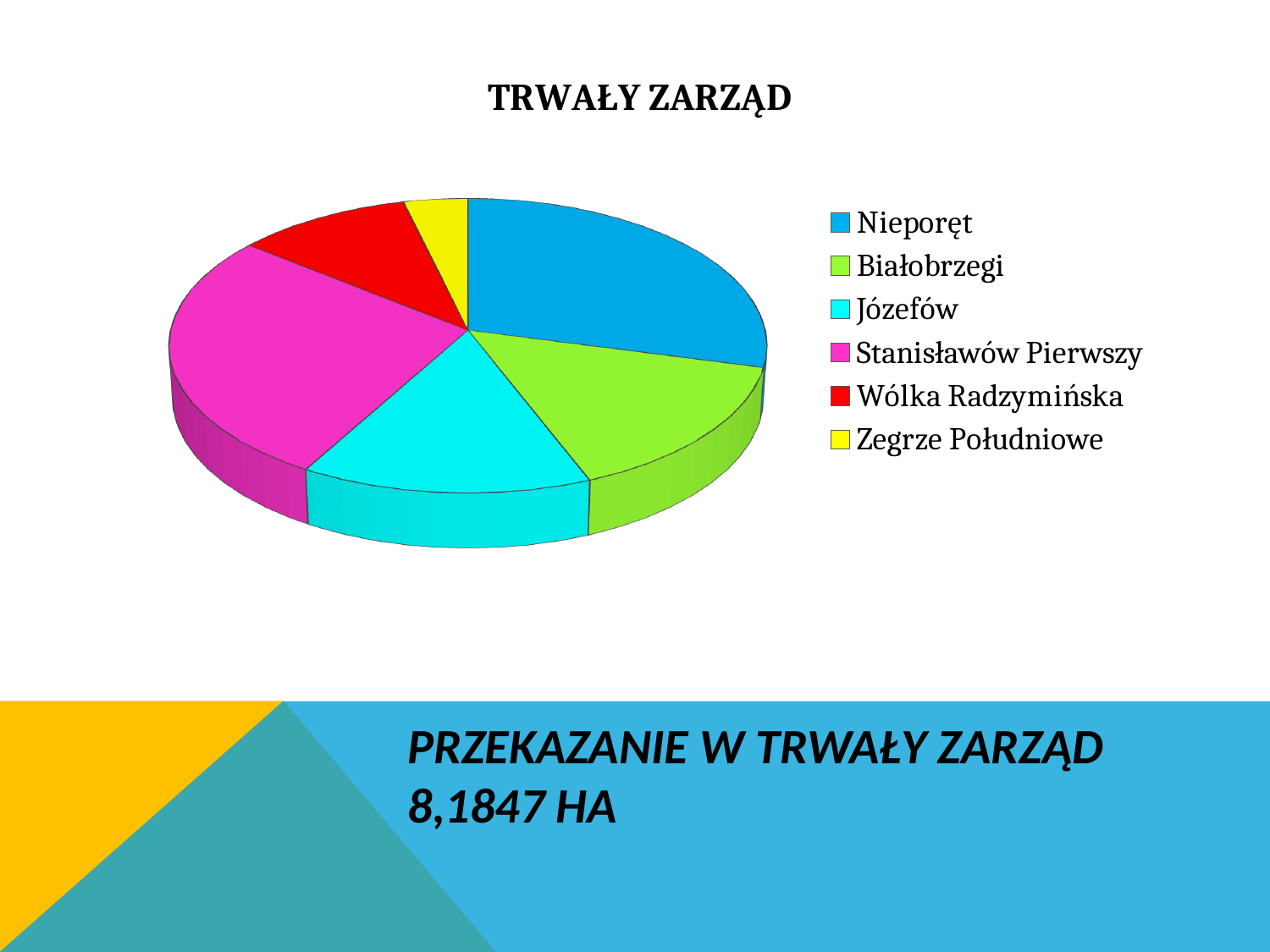
Which slice is larger, Nieporęt or Zegrze Południowe? Nieporęt What kind of chart is shown on the slide? pie chart How many entries does the legend list? 6 Which category has the smallest slice of the pie? Zegrze Południowe Which slice is larger, Józefów or Wólka Radzymińska? Józefów What colour is the slice for Józefów? cyan Which slice is larger, Stanisławów Pierwszy or Wólka Radzymińska? Stanisławów Pierwszy How many categories (slices) does the pie chart have? 6 What is the title of the chart? TRWAŁY ZARZĄD